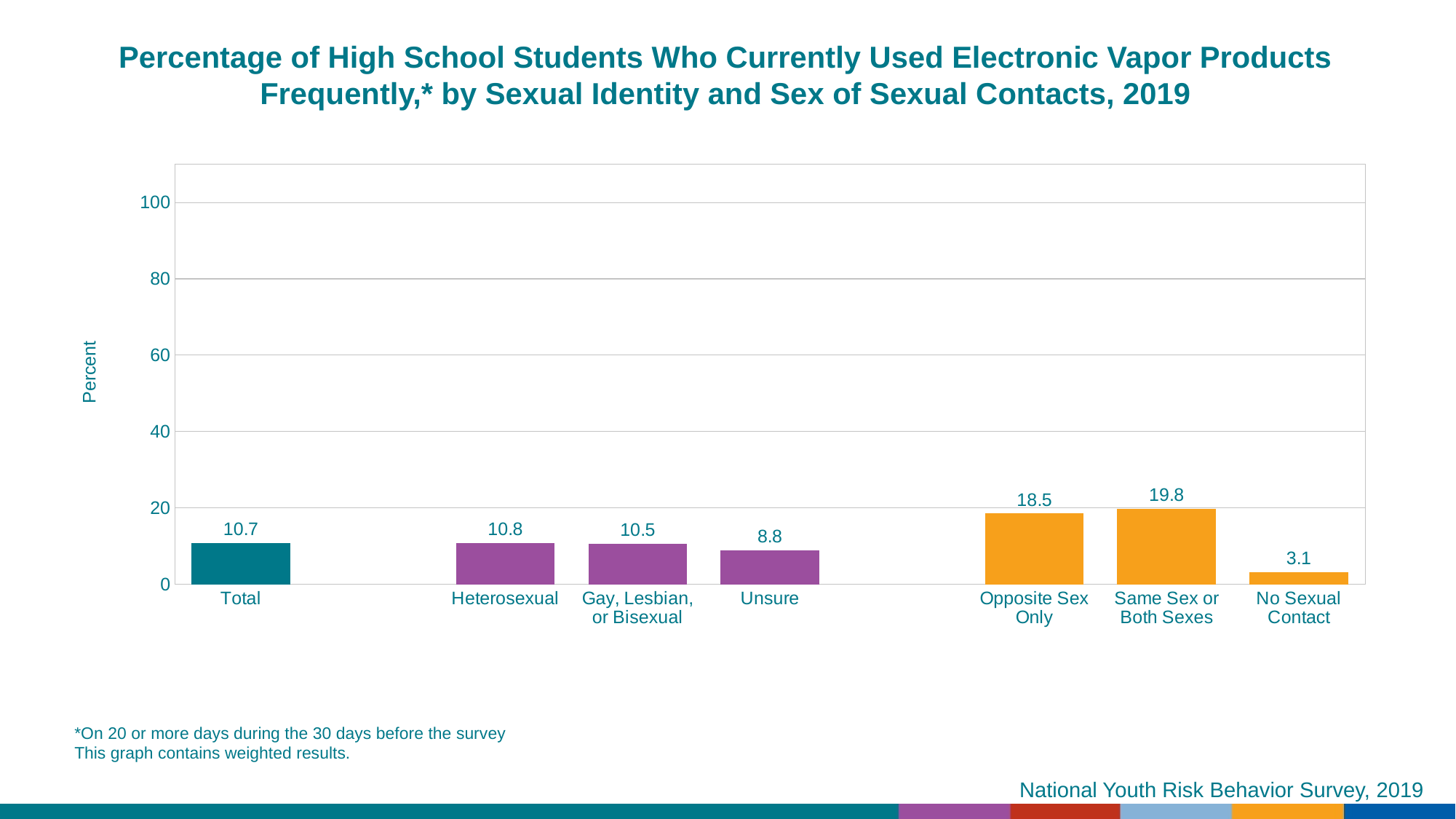
What is the value for Unsure? 8.8 What is the value for Total? 10.7 What is the label of the y axis? Percent Which is larger, the value for Heterosexual or the value for Unsure? Heterosexual What is the value for Same Sex or Both Sexes? 19.8 What is the difference between the values for Opposite Sex Only and No Sexual Contact? 15.4 Which category has the lowest value? No Sexual Contact Which category has the highest value? Same Sex or Both Sexes What kind of chart is shown on the slide? Bar chart How many categories are shown on the x axis? 7 Is the value for Opposite Sex Only greater or less than 20? less What is the value for No Sexual Contact? 3.1